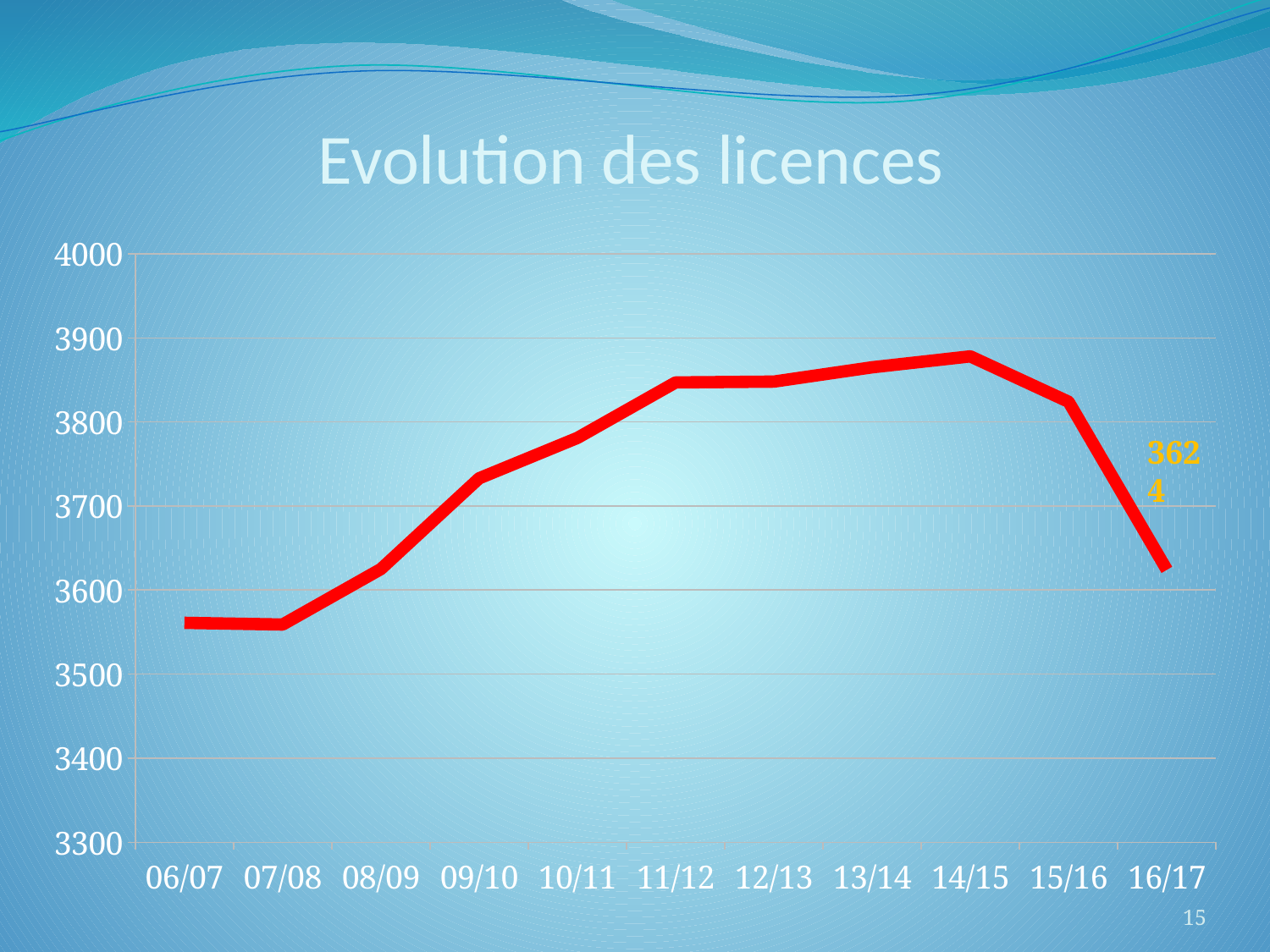
Do the values rise or fall from 06/07 to 14/15? rise Is the value for 14/15 greater or less than 3800? greater What kind of chart is shown on the slide? line chart How many seasons are plotted along the x axis? 11 What is the value for 16/17? 3624 Is the value for 06/07 greater or less than 3600? less Which season has the highest value? 14/15 Which is larger, the value for 14/15 or the value for 16/17? 14/15 Is the value for 09/10 greater or less than 3700? greater Which is larger, the value for 08/09 or the value for 09/10? 09/10 Do the values rise or fall from 14/15 to 16/17? fall What is the title of the chart? Evolution des licences